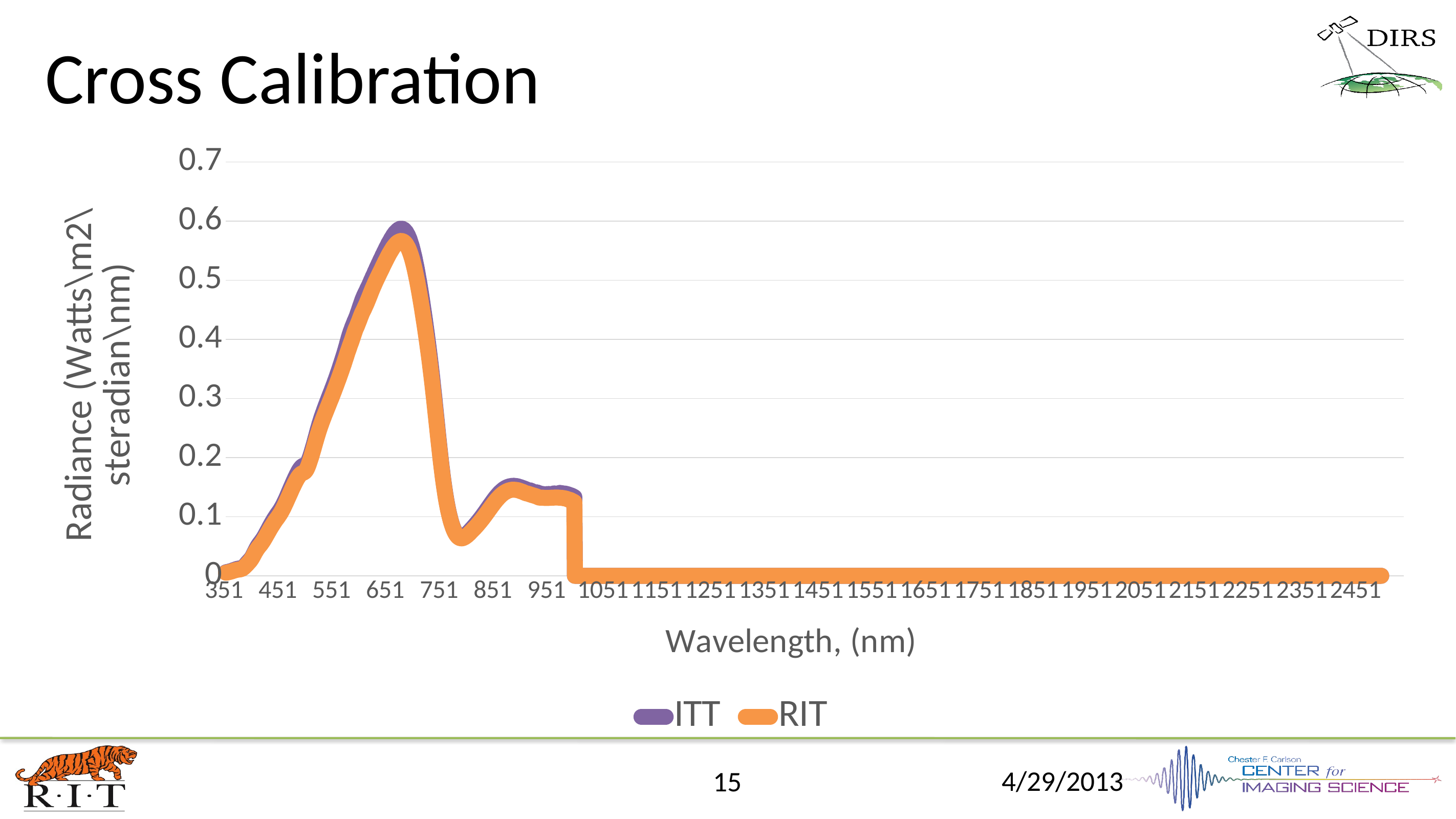
Is the value of the RIT series at 1551 nm greater or less than 0.1? less Is the peak value of the RIT series greater or less than 0.4? greater Do the values rise or fall along the x axis between 701 nm and 801 nm? fall What are the two series named in the legend? ITT and RIT How many series does the legend list? 2 Do the values rise or fall along the x axis between 351 nm and 651 nm? rise What is the label of the x axis? Wavelength, (nm) What kind of chart is shown on the slide? line chart Is the value of the ITT series at 651 nm greater or less than 0.4? greater What is the highest value shown on the y axis? 0.7